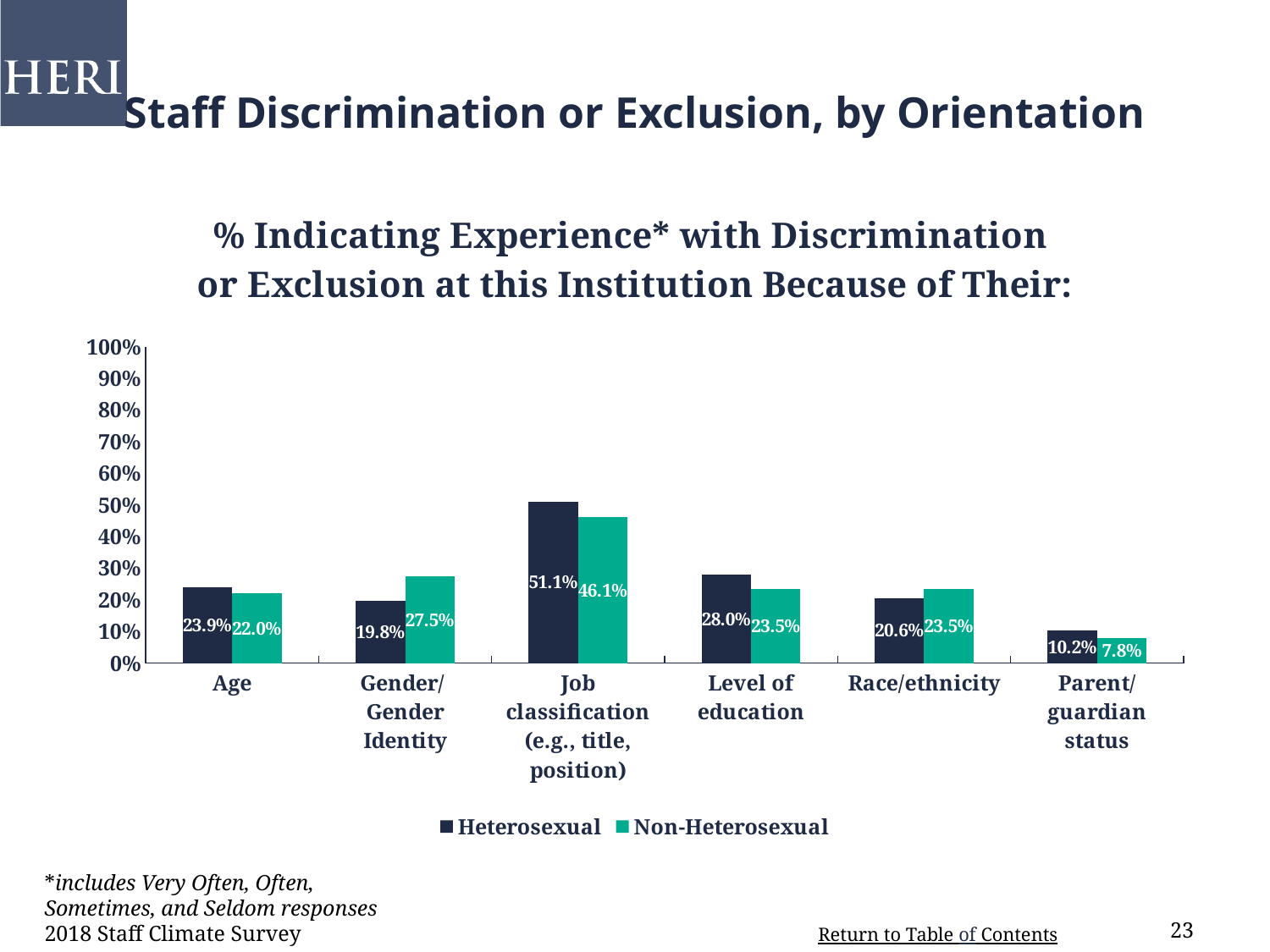
Is the Heterosexual value for Race/ethnicity greater or less than 30%? less For Level of education, which series has the larger value, Heterosexual or Non-Heterosexual? Heterosexual What is the difference between the Heterosexual and Non-Heterosexual values for Job classification? 5.0% How many series does the legend list? 2 What is the Non-Heterosexual value for Parent/guardian status? 7.8% What is the Heterosexual value for Job classification (e.g., title, position)? 51.1% What percentage of Heterosexual staff indicated experience with discrimination or exclusion because of their Age? 23.9% What kind of chart is shown on the slide? Bar chart What is the Non-Heterosexual value for Gender/Gender Identity? 27.5% Which category has the lowest value for the Heterosexual series? Parent/guardian status How many categories are shown on the x axis? 6 Which category has the highest value for the Non-Heterosexual series? Job classification (e.g., title, position)